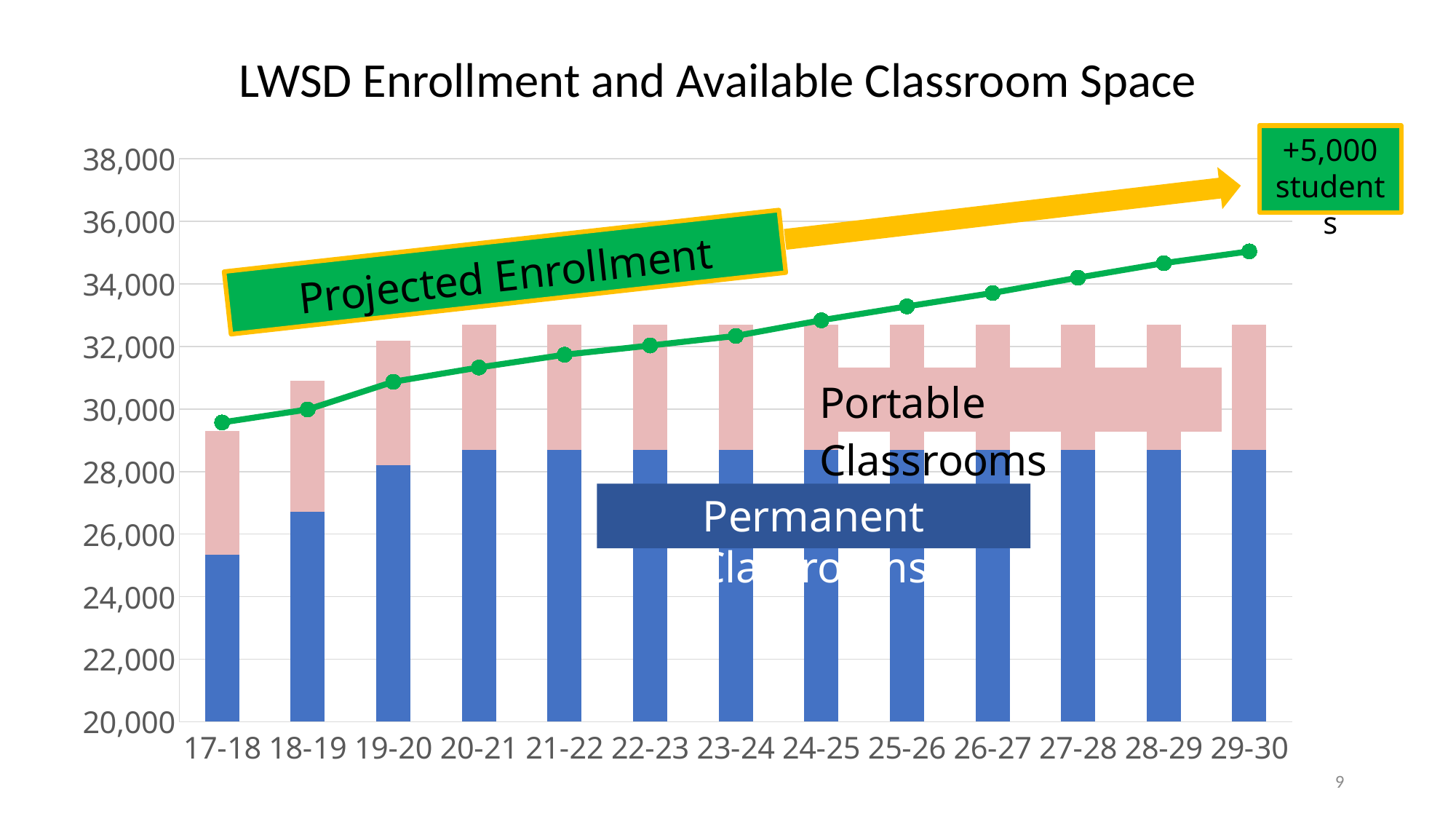
Is the total height of the stacked bar for 20-21 greater or less than 32,000? greater For 29-30, which is higher: the Projected Enrollment line or the top of the stacked classroom bar? Projected Enrollment line Does the Projected Enrollment line rise or fall from 17-18 to 29-30? Rises How many school years are shown along the x axis? 13 In which school year is the Permanent Classrooms bar lowest? 17-18 What is the title of the chart? LWSD Enrollment and Available Classroom Space Is the Permanent Classrooms value for 17-18 greater or less than 26,000? less Which series is shown by the green line? Projected Enrollment In which school year is Projected Enrollment lowest? 17-18 In which school year is Projected Enrollment highest? 29-30 What kind of chart is shown on the slide? A combination of a stacked bar chart and a line chart Is the Projected Enrollment value for 29-30 greater or less than 34,000? greater